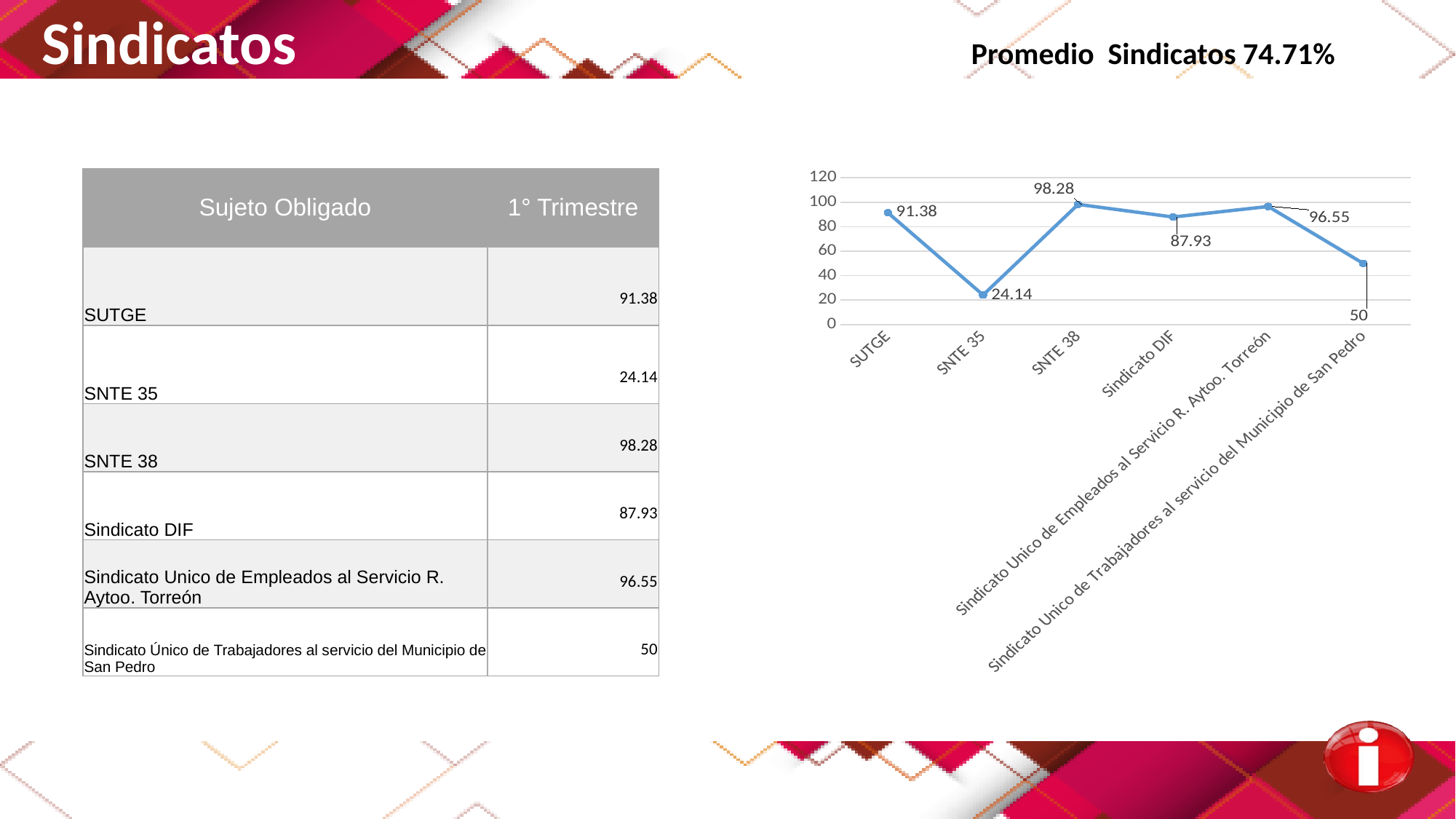
What is the maximum value shown on the chart's vertical axis? 120 What is the value for SNTE 35 in the chart? 24.14 What is the value for SUTGE in the chart? 91.38 What type of chart is shown on the slide? line chart Which category has the highest value in the chart? SNTE 38 What is the value for Sindicato DIF in the chart? 87.93 How many categories are plotted on the x axis of the chart? 6 Is the value for Sindicato Unico de Empleados al Servicio R. Aytoo. Torreón greater or less than 80? greater Which category has the lowest value in the chart? SNTE 35 What is the value for Sindicato Unico de Trabajadores al servicio del Municipio de San Pedro in the chart? 50 What is the difference between the values for SNTE 38 and SNTE 35? 74.14 Which is larger, the value for SUTGE or the value for Sindicato DIF? SUTGE